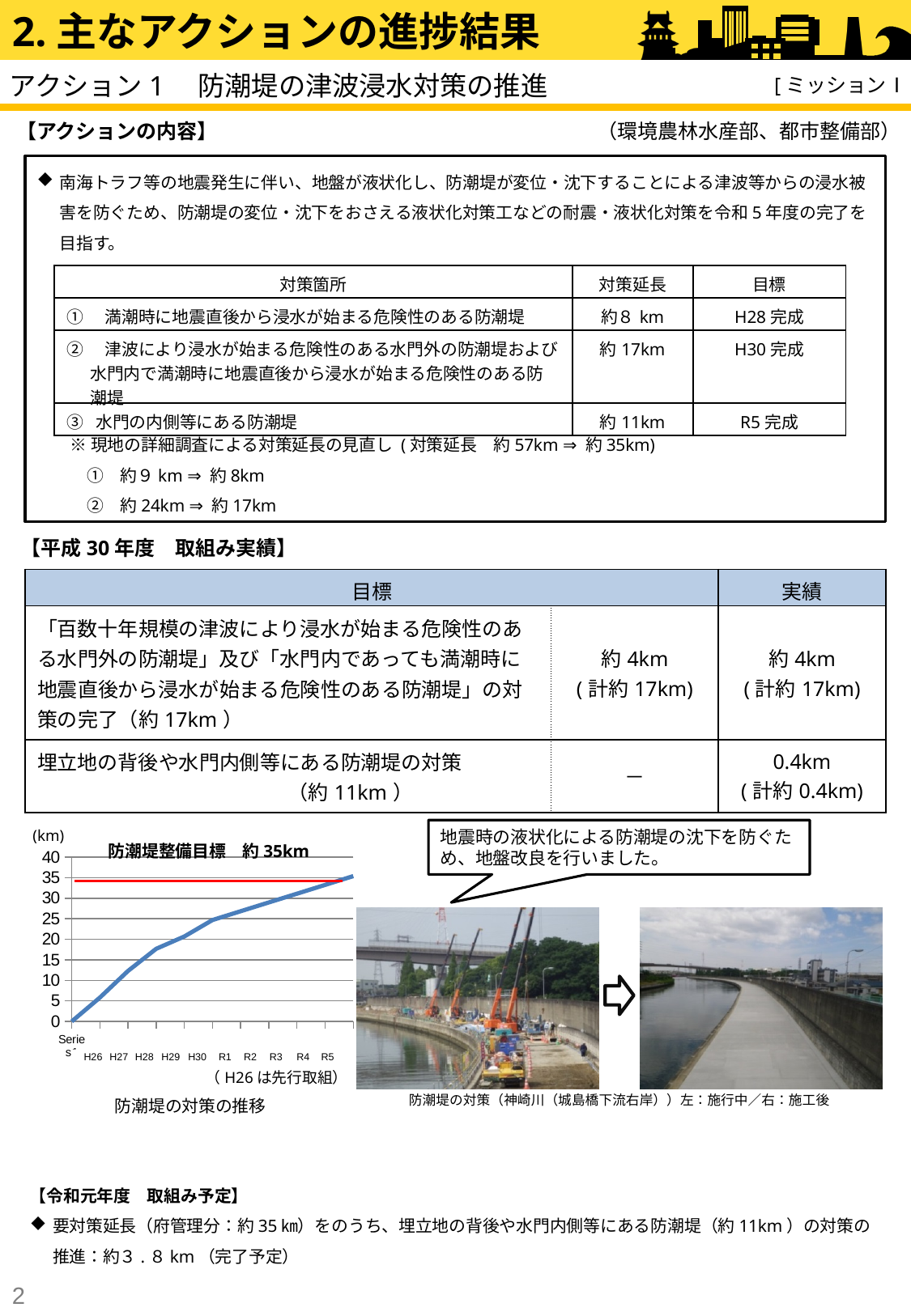
In the chart 防潮堤の対策の推移, which fiscal year has the highest value? R5 In the chart 防潮堤の対策の推移, is the value for H27 greater or less than 15? less What kind of chart is shown at the bottom left of the slide (防潮堤の対策の推移)? line chart What title is printed inside the chart 防潮堤の対策の推移? 防潮堤整備目標 約35km What unit is shown on the y axis of the chart 防潮堤の対策の推移? km In the chart 防潮堤の対策の推移, do the values rise or fall from H26 to R5? rise In the chart 防潮堤の対策の推移, which fiscal year has the lowest value? H26 In the chart 防潮堤の対策の推移, is the value for H30 greater or less than 20? greater In the chart 防潮堤の対策の推移, is the value for R2 greater or less than 25? greater How many fiscal-year labels from H26 to R5 are shown on the x axis of the chart 防潮堤の対策の推移? 10 In the chart 防潮堤の対策の推移, which is larger, the value for H30 or the value for R3? R3